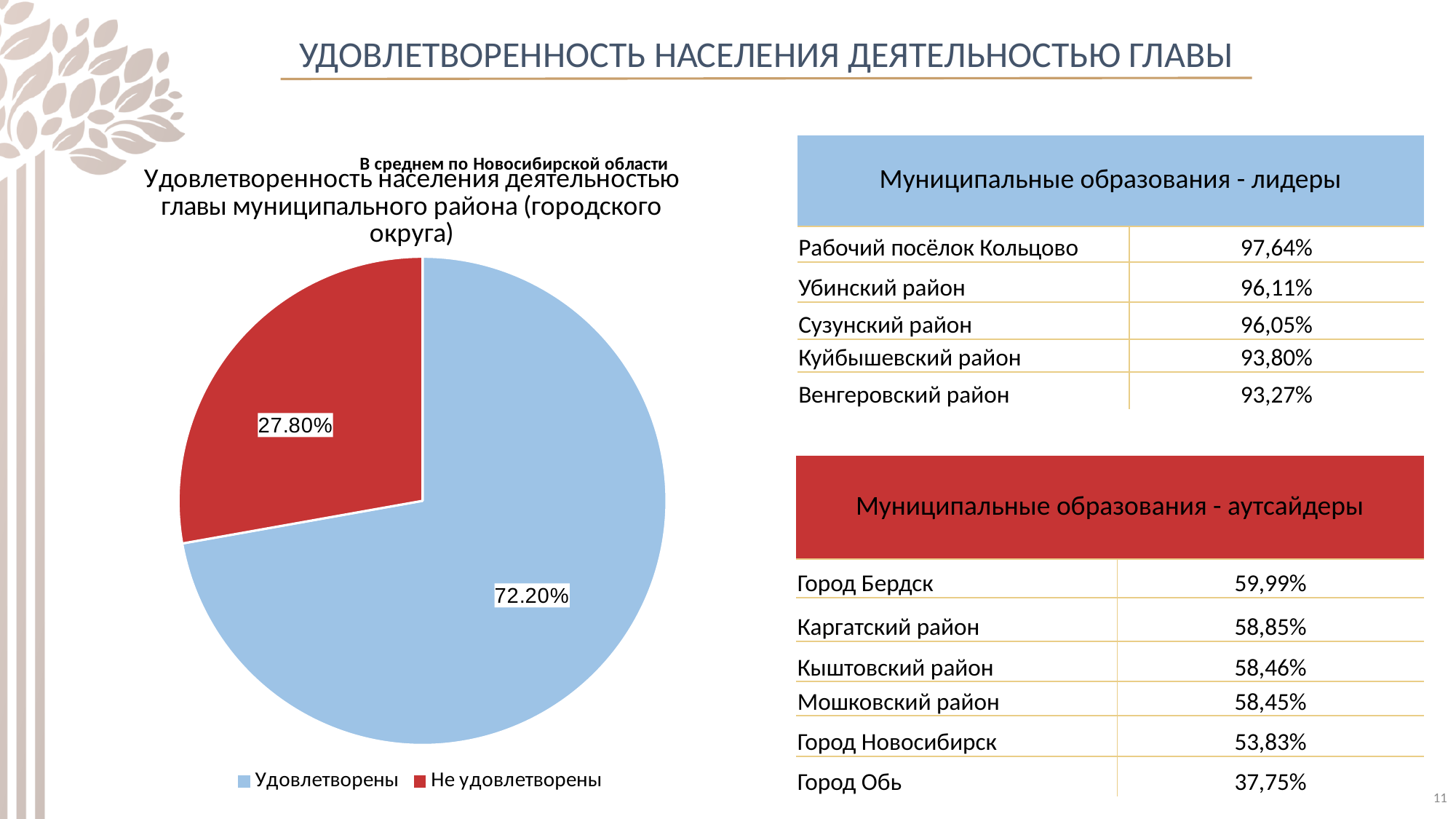
What colour is the Удовлетворены slice in the pie chart? blue Which slice of the pie chart is the smallest? Не удовлетворены What is the value for Не удовлетворены in the pie chart? 27.80% What is the difference between the Удовлетворены and Не удовлетворены slices in the pie chart? 44.40% What share of the pie does the Не удовлетворены slice represent? 27.80% How many slices does the pie chart have? 2 Which slice of the pie chart is the largest? Удовлетворены What colour is the Не удовлетворены slice in the pie chart? red What is the value for Удовлетворены in the pie chart? 72.20% Which is larger in the pie chart: Удовлетворены or Не удовлетворены? Удовлетворены How many entries does the legend of the pie chart list? 2 What kind of chart is shown on the slide? pie chart